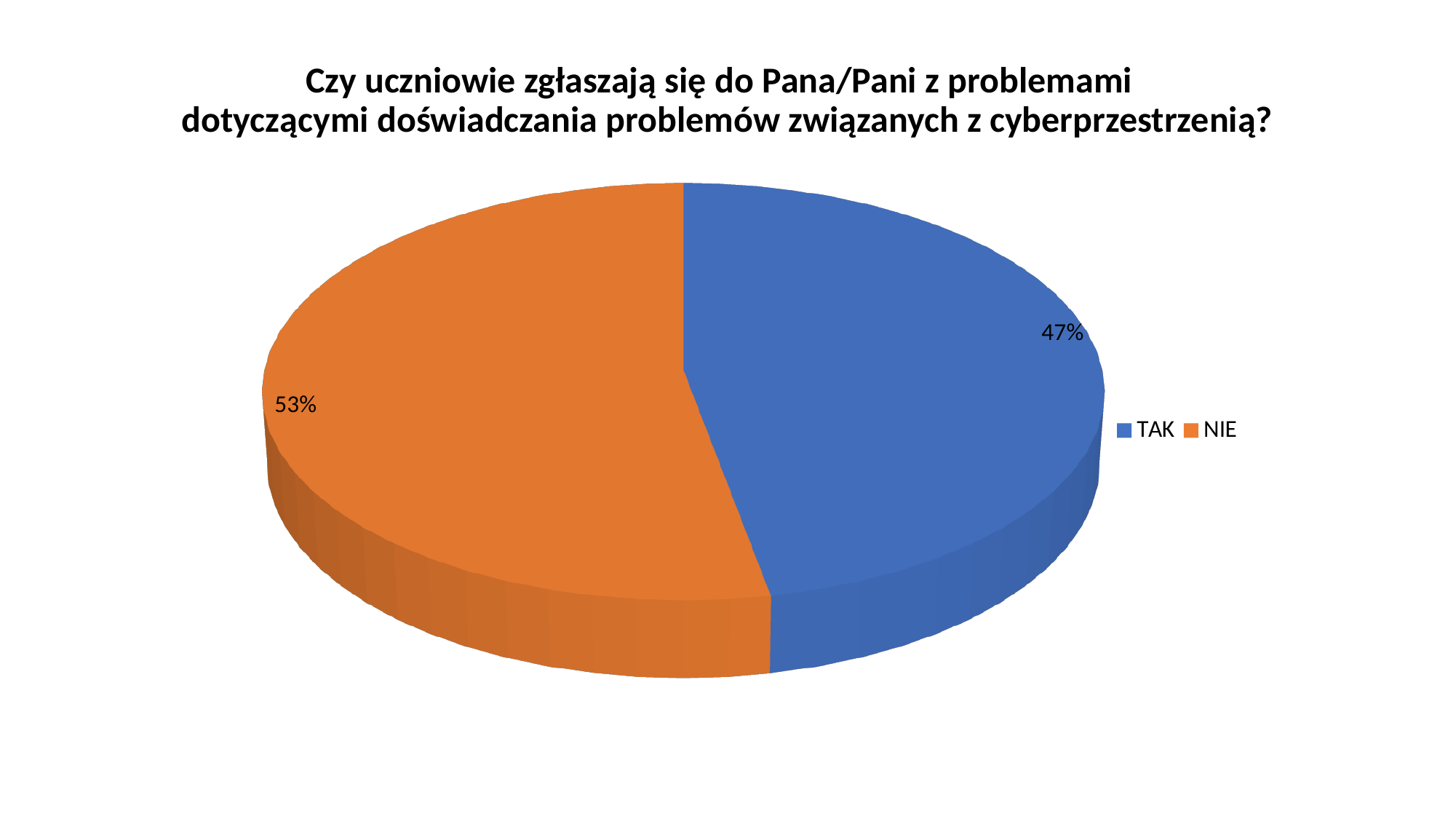
What kind of chart is shown on the slide? pie chart What percentage is shown for TAK? 47% What colour is the NIE slice? orange How many slices does the pie chart have? 2 What share of the pie does the TAK slice represent? 47% Which category has the smallest share of the pie? TAK What colour is the TAK slice? blue Which category has the largest share of the pie? NIE How many entries does the legend list? 2 What is the difference in percentage points between NIE and TAK? 6 What percentage is shown for NIE? 53% Which is larger, the share for TAK or the share for NIE? NIE